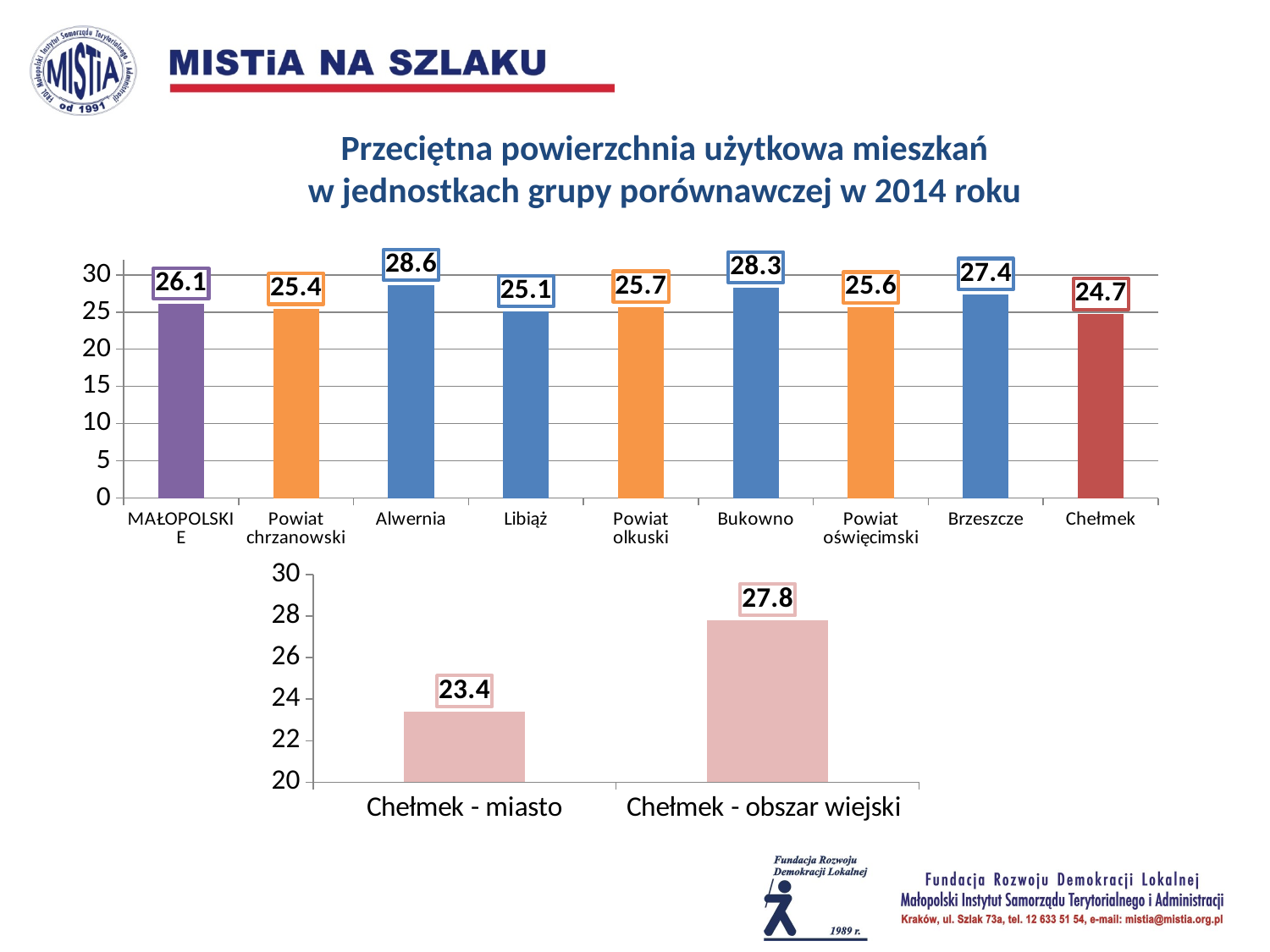
In the bottom chart, what is the value for Chełmek - obszar wiejski? 27.8 In the bottom chart, what is the difference between the values for Chełmek - obszar wiejski and Chełmek - miasto? 4.4 In the top chart, what is the value for MAŁOPOLSKIE? 26.1 How many categories are shown in the top chart? 9 In the top chart, which category has the lowest value? Chełmek In the top chart, what is the value for Chełmek? 24.7 In the top chart, which category has the highest value? Alwernia In the top chart, what is the difference between the values for Bukowno and Libiąż? 3.2 In the top chart, which is larger, the value for Brzeszcze or the value for Powiat olkuski? Brzeszcze What kind of chart is the bottom chart? bar chart In the top chart, is the value for Powiat chrzanowski greater or less than 25? greater In the top chart, what is the value for Alwernia? 28.6